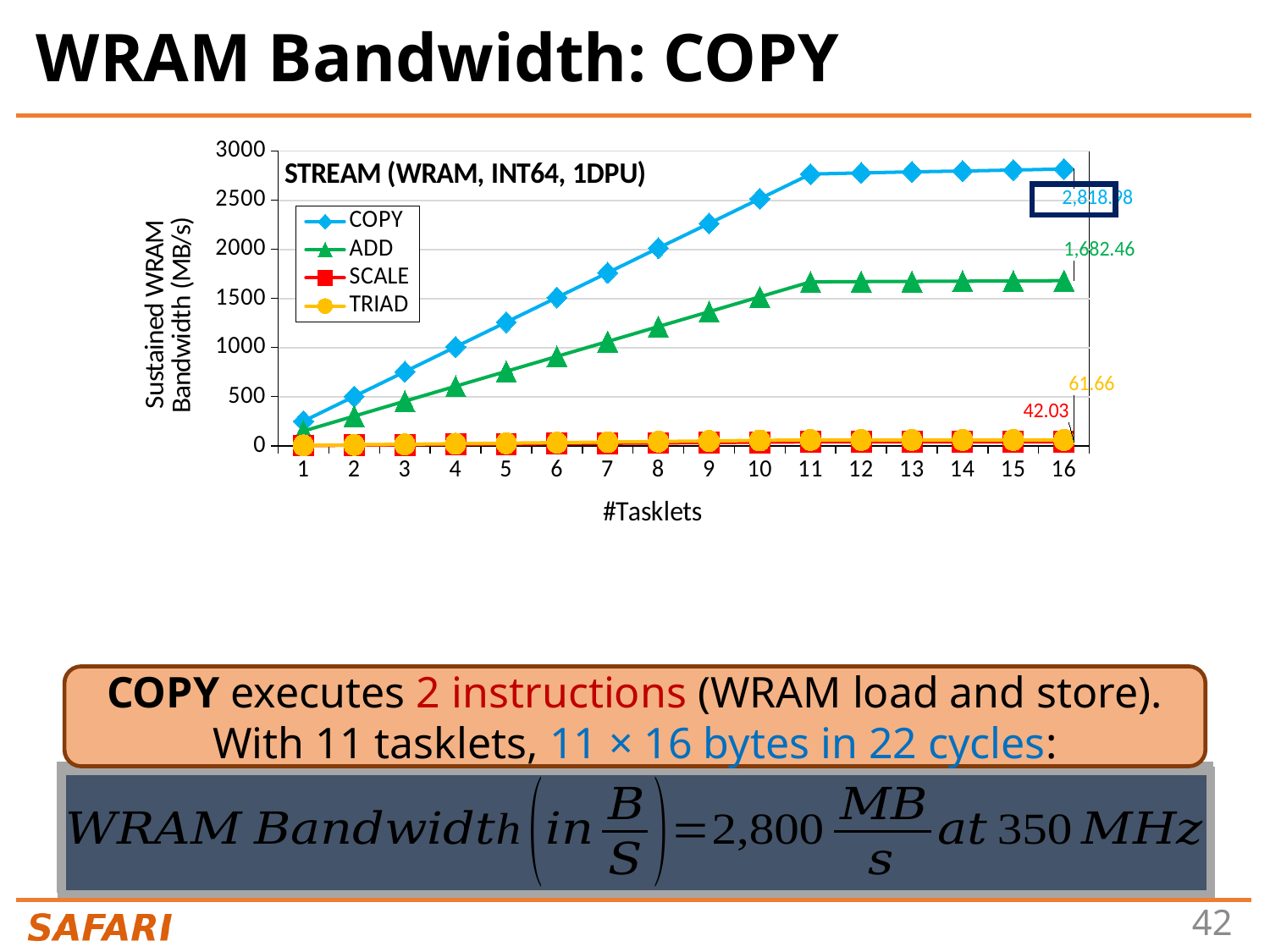
What kind of chart is shown on the slide? line chart How many tasklet counts are plotted along the x axis? 16 What is the ADD bandwidth at 16 tasklets? 1,682.46 What is the TRIAD bandwidth at 16 tasklets? 61.66 Is the COPY value at 8 tasklets greater or less than 1500? greater How many series does the chart legend list? 4 At 16 tasklets, which is larger: the TRIAD value or the SCALE value? TRIAD What is the SCALE bandwidth at 16 tasklets? 42.03 Which series has the lowest bandwidth at 16 tasklets? SCALE What is the difference between the TRIAD and SCALE values at 16 tasklets? 19.63 What is the label of the x axis? #Tasklets Which series has the highest bandwidth at 16 tasklets? COPY